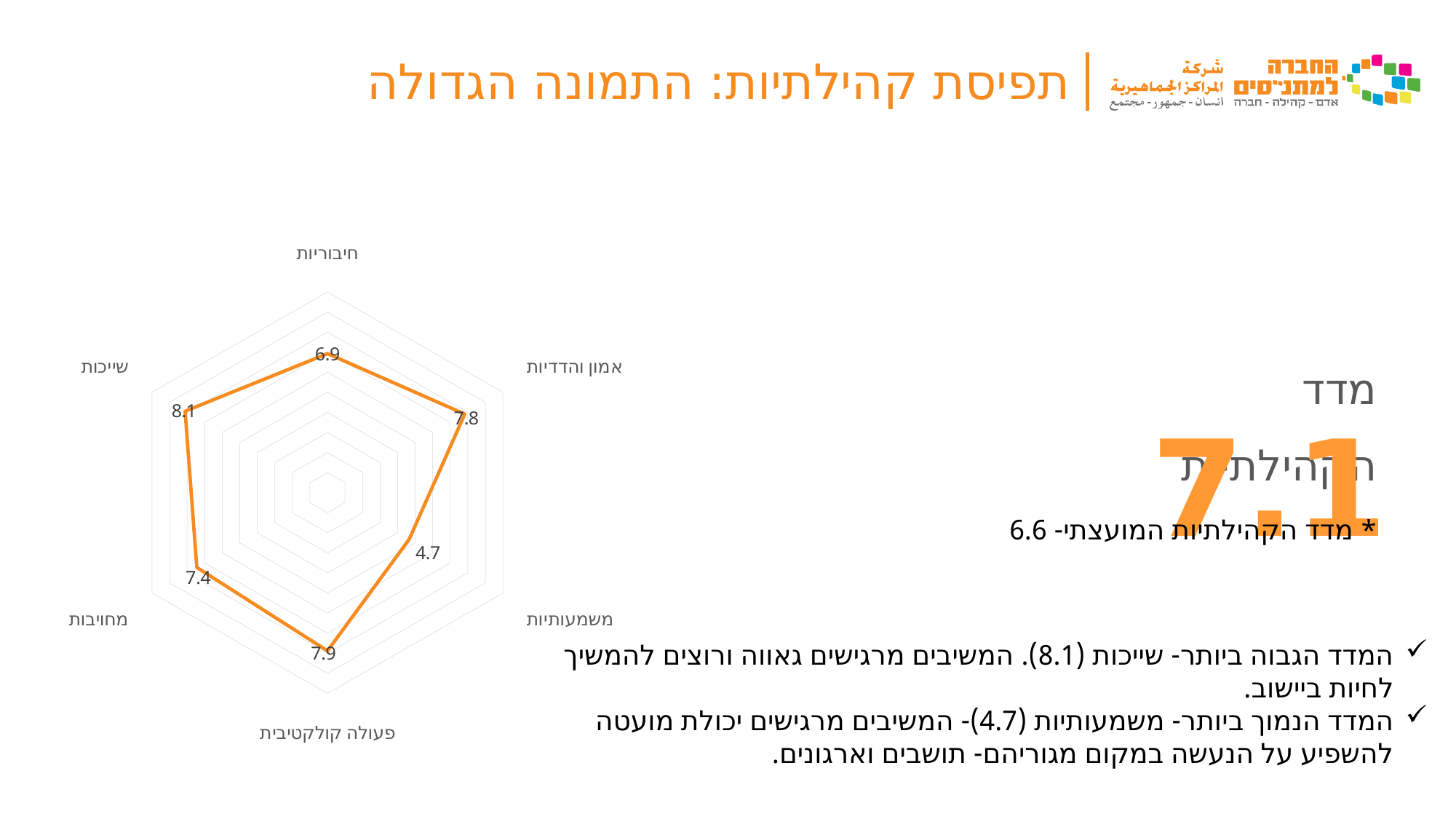
What is the value for מחויבות? 7.4 What colour is the data line on the radar chart? orange Which category has the lowest value? משמעותיות What is the value for משמעותיות? 4.7 How many categories does the radar chart have? 6 What is the difference between the values for שייכות and משמעותיות? 3.4 What is the value for פעולה קולקטיבית? 7.9 Which category has the highest value? שייכות What is the value for חיבוריות? 6.9 What is the value for אמון והדדיות? 7.8 What kind of chart is shown on the slide? radar chart Which is larger, the value for מחויבות or the value for חיבוריות? מחויבות